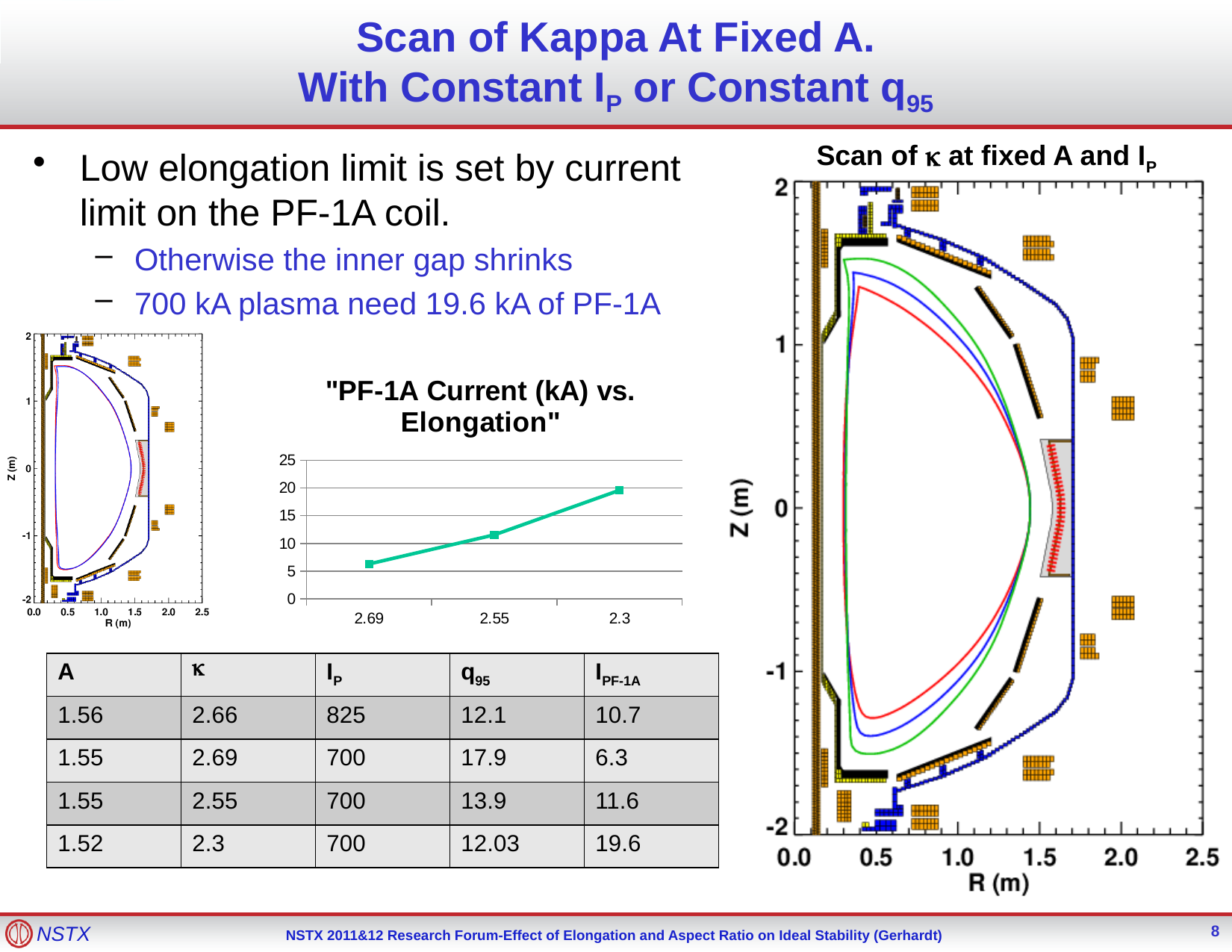
What kind of chart is "PF-1A Current (kA) vs. Elongation"? line chart In the "PF-1A Current (kA) vs. Elongation" chart, is the value for elongation 2.55 greater or less than 15? less How many data points are plotted in the "PF-1A Current (kA) vs. Elongation" chart? 3 In the "PF-1A Current (kA) vs. Elongation" chart, is the value for elongation 2.69 greater or less than 10? less In the "PF-1A Current (kA) vs. Elongation" chart, is the value for elongation 2.55 greater or less than 10? greater What is the highest tick value shown on the y axis of the "PF-1A Current (kA) vs. Elongation" chart? 25 In the "PF-1A Current (kA) vs. Elongation" chart, which has the larger value: elongation 2.55 or elongation 2.69? 2.55 What is the title of the line chart in the middle of the slide? "PF-1A Current (kA) vs. Elongation" In the "PF-1A Current (kA) vs. Elongation" chart, do the values rise or fall moving left to right along the x axis? rise In the "PF-1A Current (kA) vs. Elongation" chart, which elongation category has the lowest PF-1A current? 2.69 In the "PF-1A Current (kA) vs. Elongation" chart, which elongation category has the highest PF-1A current? 2.3